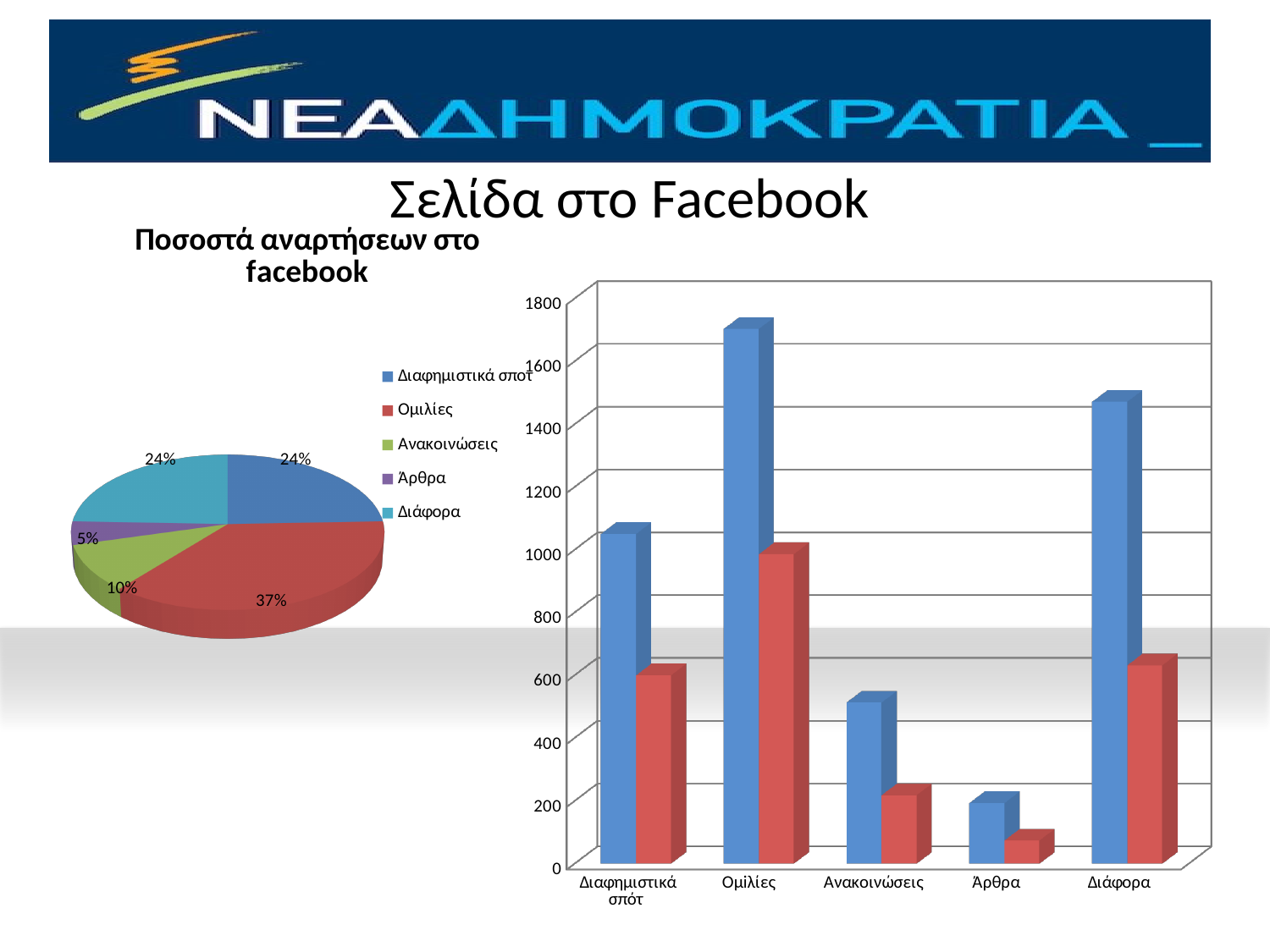
In the bar chart on the right, is the red bar for Άρθρα greater or less than 200? less How many categories are shown on the x axis of the bar chart on the right? 5 How many entries does the legend of the pie chart 'Ποσοστά αναρτήσεων στο facebook' list? 5 In the bar chart on the right, is the blue bar for Ομιλίες greater or less than 1600? greater In the pie chart 'Ποσοστά αναρτήσεων στο facebook', which category has the largest share? Ομιλίες In the bar chart on the right, which category has the tallest blue bar? Ομιλίες What kind of chart is the chart on the right side of the slide? Bar chart In the pie chart 'Ποσοστά αναρτήσεων στο facebook', what percentage is shown for Ομιλίες? 37% In the pie chart 'Ποσοστά αναρτήσεων στο facebook', what percentage is shown for Ανακοινώσεις? 10% In the pie chart 'Ποσοστά αναρτήσεων στο facebook', which category has the smallest share? Άρθρα In the pie chart 'Ποσοστά αναρτήσεων στο facebook', what percentage is shown for Άρθρα? 5% In the pie chart 'Ποσοστά αναρτήσεων στο facebook', what is the difference in percentage points between Ομιλίες and Διάφορα? 13